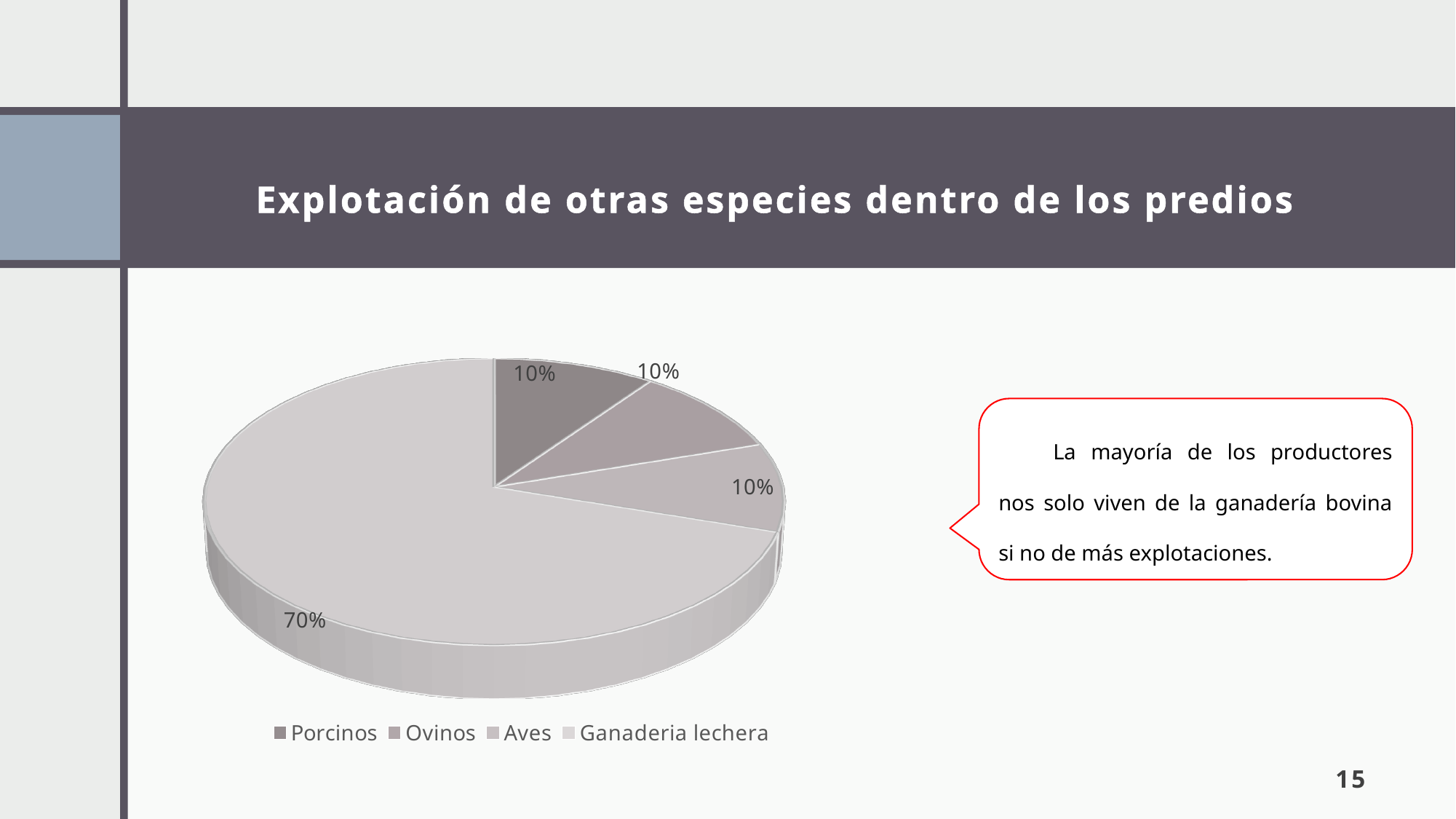
What is the value shown for Porcinos? 10% Which is larger, the share for Ganaderia lechera or the share for Porcinos? Ganaderia lechera What kind of chart is shown on the slide? pie chart What percentage of the pie does Ganaderia lechera represent? 70% What is the combined share of Porcinos, Ovinos and Aves? 30% Which category has the largest share of the pie chart? Ganaderia lechera What is the title shown above the chart on the slide? Explotación de otras especies dentro de los predios What are the four entries listed in the chart legend? Porcinos, Ovinos, Aves, Ganaderia lechera What is the difference between the share for Ganaderia lechera and the share for Ovinos? 60% How many categories does the pie chart show? 4 What is the value shown for Aves? 10% How many categories in the pie chart have a share of 10%? 3